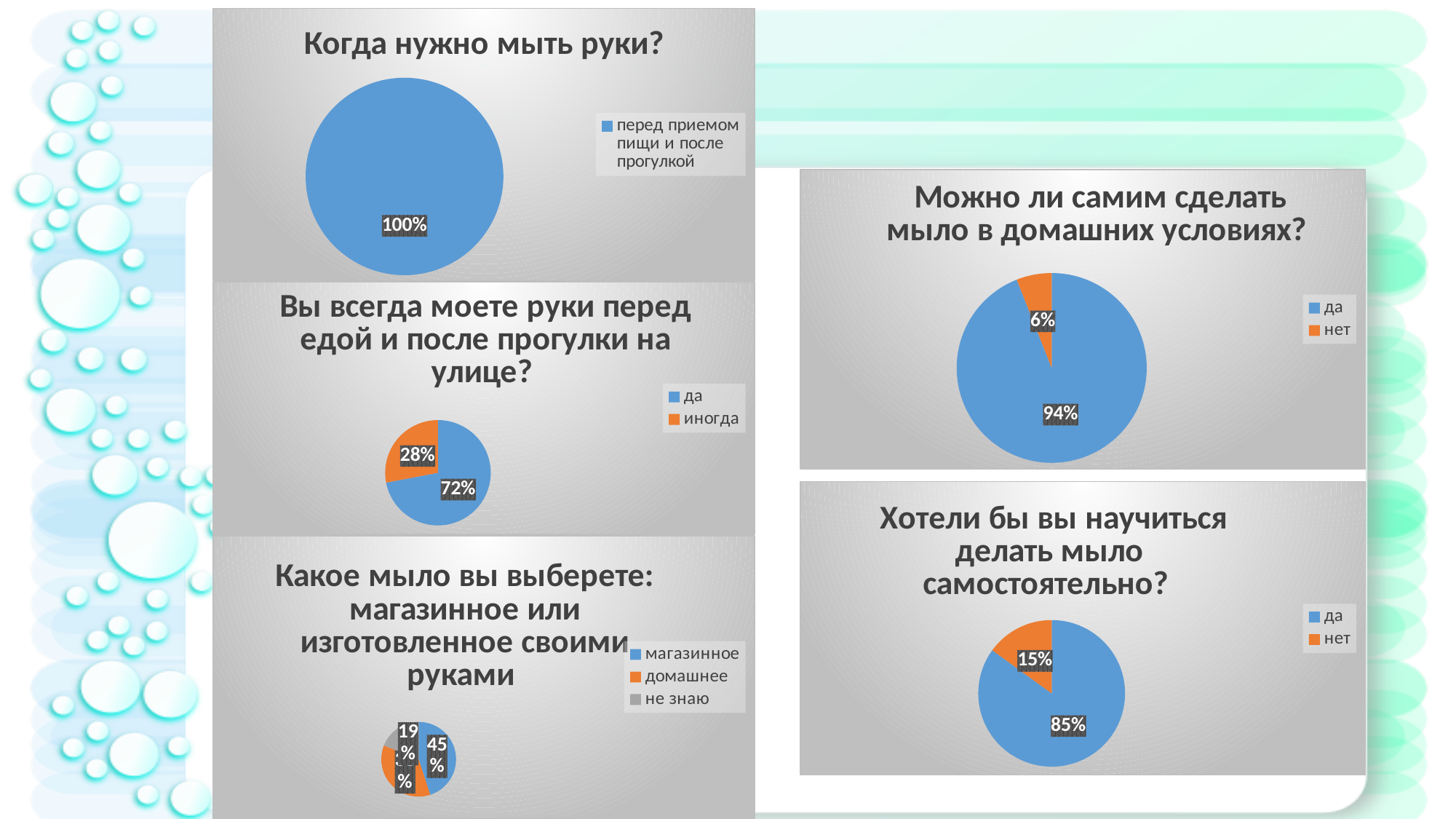
In the chart titled "Какое мыло вы выберете: магазинное или изготовленное своими руками", what share of respondents chose "магазинное"? 45% In the chart titled "Какое мыло вы выберете: магазинное или изготовленное своими руками", which option has the largest share? магазинное How many entries does the legend of the chart titled "Какое мыло вы выберете: магазинное или изготовленное своими руками" list? 3 In the chart titled "Вы всегда моете руки перед едой и после прогулки на улице?", which answer has the larger share, "да" or "иногда"? да In the chart titled "Можно ли самим сделать мыло в домашних условиях?", what share of respondents answered "нет"? 6% In the chart titled "Хотели бы вы научиться делать мыло самостоятельно?", what is the difference between the "да" and "нет" shares? 70% In the chart titled "Вы всегда моете руки перед едой и после прогулки на улице?", what share of respondents answered "иногда"? 28% In the chart titled "Хотели бы вы научиться делать мыло самостоятельно?", what share of respondents answered "да"? 85% In the chart titled "Когда нужно мыть руки?", what share does the single slice represent? 100% In the chart titled "Вы всегда моете руки перед едой и после прогулки на улице?", what share of respondents answered "да"? 72% What kind of chart is used for "Можно ли самим сделать мыло в домашних условиях?"? pie chart In the chart titled "Можно ли самим сделать мыло в домашних условиях?", what share of respondents answered "да"? 94%